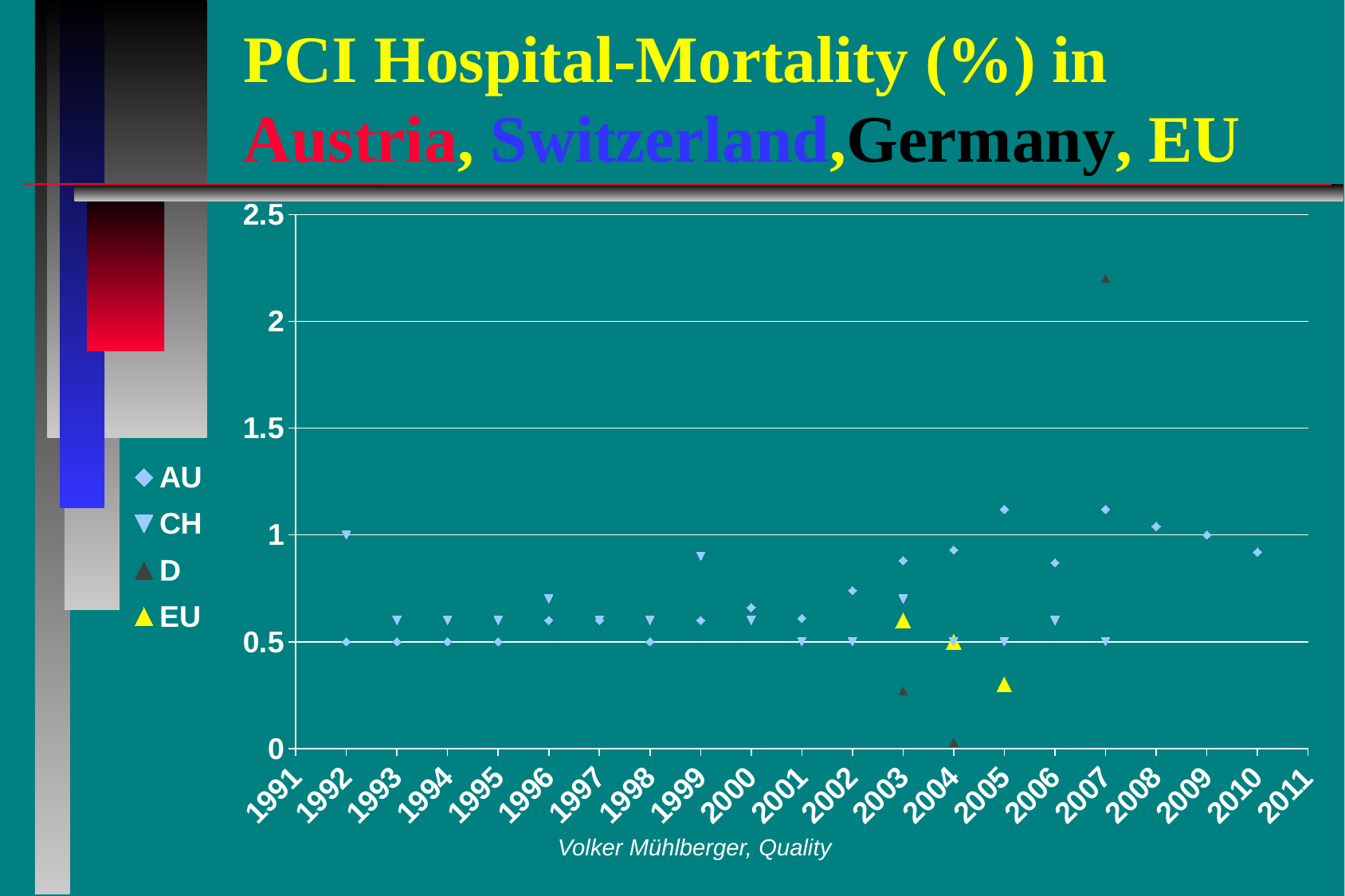
How many series does the legend list? 4 Is the value for EU in 2005 greater or less than 0.5? less What kind of chart is shown on the slide? scatter chart Do the AU values rise or fall from 1995 to 2005? rise Is the value for AU in 2005 greater or less than 1? greater Is the value for D in 2007 greater or less than 2? greater In 2005, which is larger, the value for AU or the value for CH? AU Which series are listed in the legend? AU, CH, D, EU How many years are labelled on the x axis? 21 Which series has the highest plotted value on the chart? D